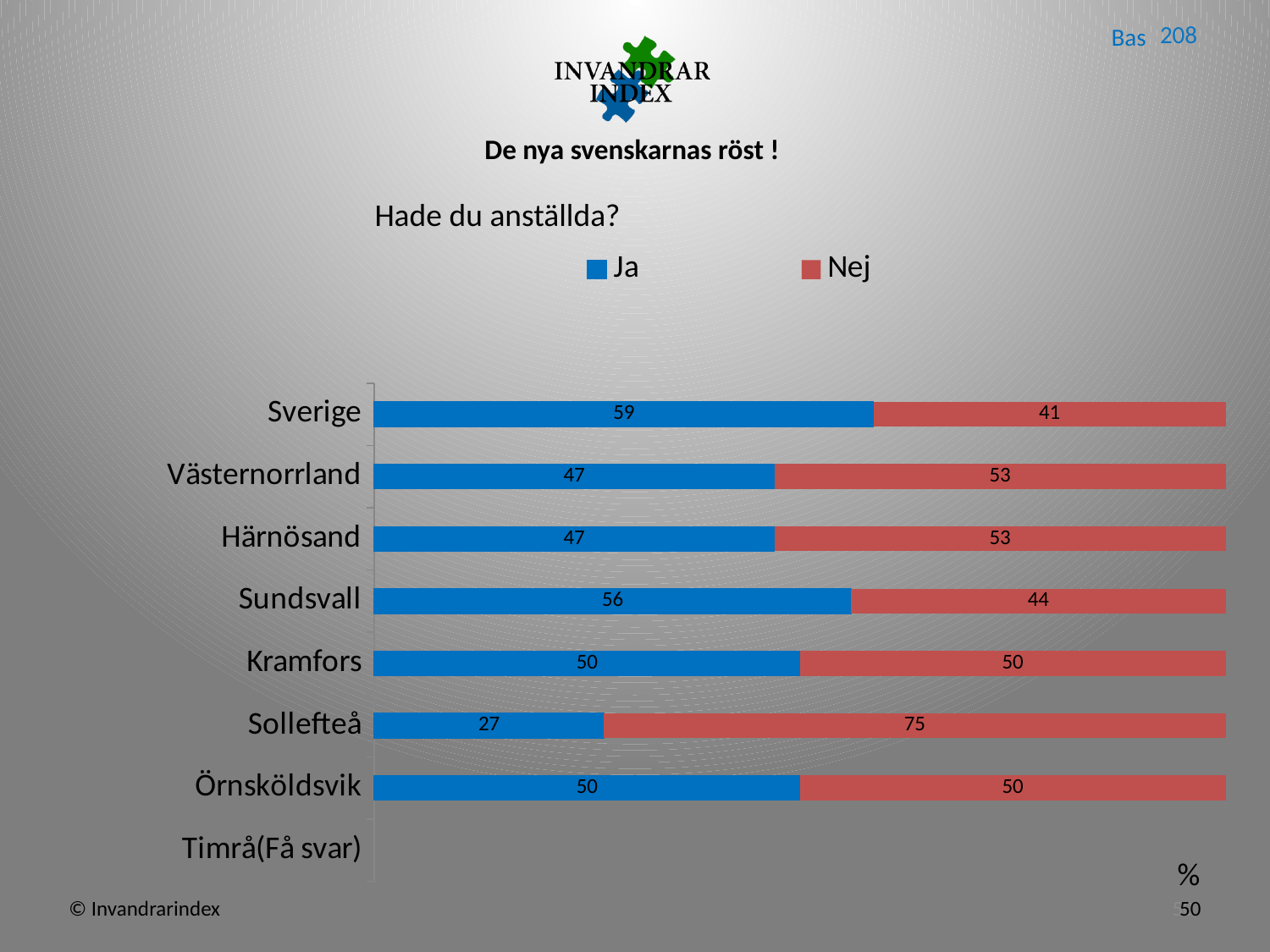
How many series does the legend list? 2 Which category has the lowest value for Ja? Sollefteå What is the value for Nej for Sollefteå? 75 What kind of chart is shown on the slide? Stacked bar chart What is the difference between the Nej value for Sollefteå and the Nej value for Sverige? 34 Which is larger, the Ja value for Sundsvall or the Ja value for Härnösand? Sundsvall Which category has the highest value for Ja? Sverige How many categories are listed on the vertical axis? 8 What is the value for Nej for Västernorrland? 53 What is the value for Ja for Sundsvall? 56 What is the title of the chart? Hade du anställda? What is the value for Ja for Sverige? 59